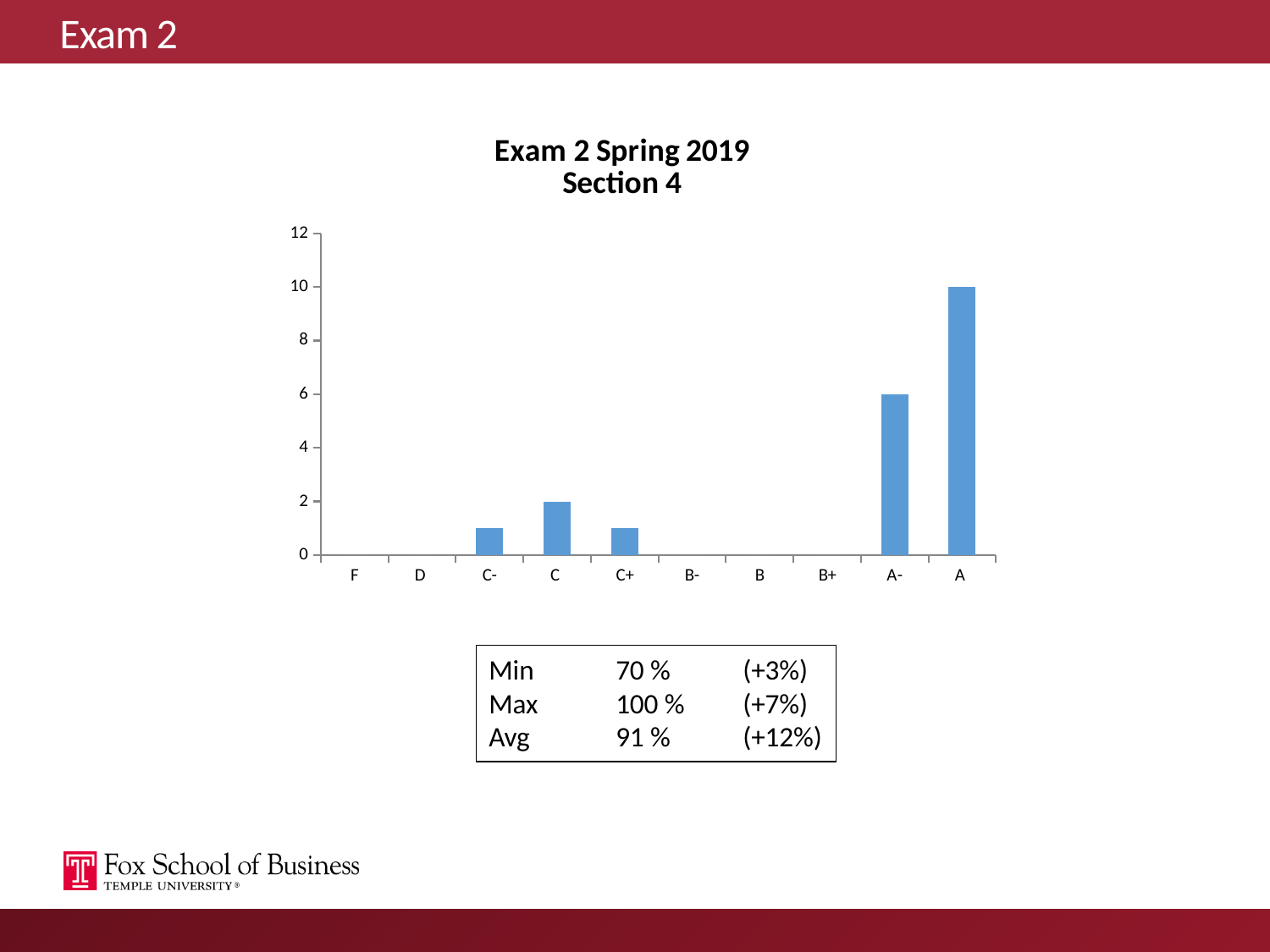
What is the title of the chart? Exam 2 Spring 2019 Section 4 What is the value for grade A-? 6 What is the difference between the values for A and A-? 4 Is the value for C+ greater or less than 2? less What is the value for grade C? 2 What is the value for grade A? 10 Which grade category has the highest bar? A How many grade categories are shown on the x axis of the chart? 10 What is the difference between the values for A and C? 8 Is the value for C- greater or less than 2? less Which is larger, the value for A- or the value for C? A- What kind of chart is shown on the slide? bar chart